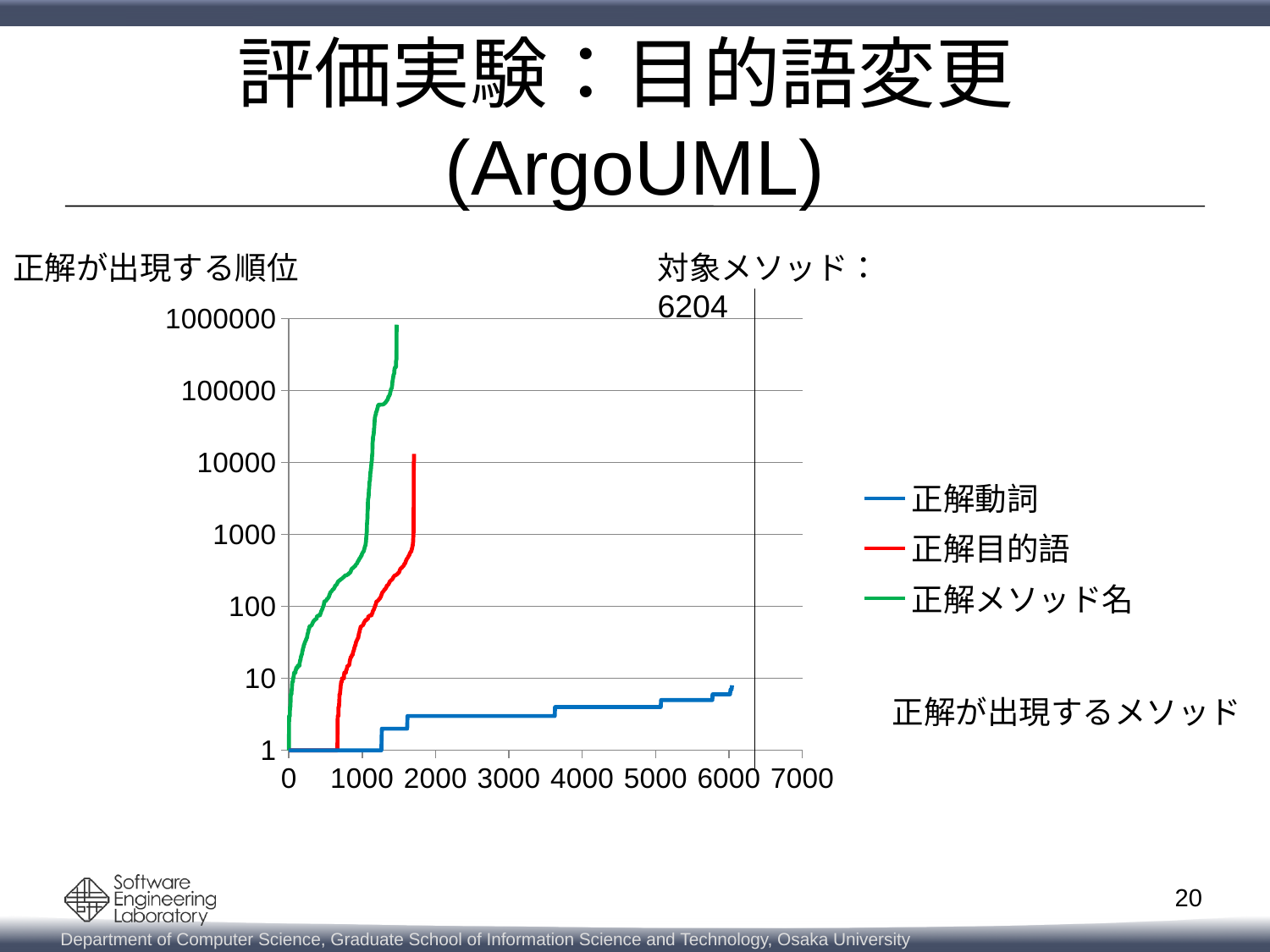
How many series does the chart's legend list? 3 Which series extends furthest along the x axis, 正解動詞 or 正解目的語? 正解動詞 Is the value of the 正解動詞 line at x = 3000 greater or less than 10? less Which series reaches the highest value on the y axis? 正解メソッド名 Is the value of the 正解目的語 line at x = 1000 greater or less than 100? less What kind of chart is shown on the slide? line chart Which series stays lowest on the y axis across the chart? 正解動詞 Which series is drawn in green according to the legend? 正解メソッド名 Is the highest value reached by the 正解メソッド名 line greater or less than 100000? greater Does the 正解動詞 line rise or fall as the x axis increases? rise Which series is drawn in blue according to the legend? 正解動詞 What is the maximum value shown on the y axis? 1000000